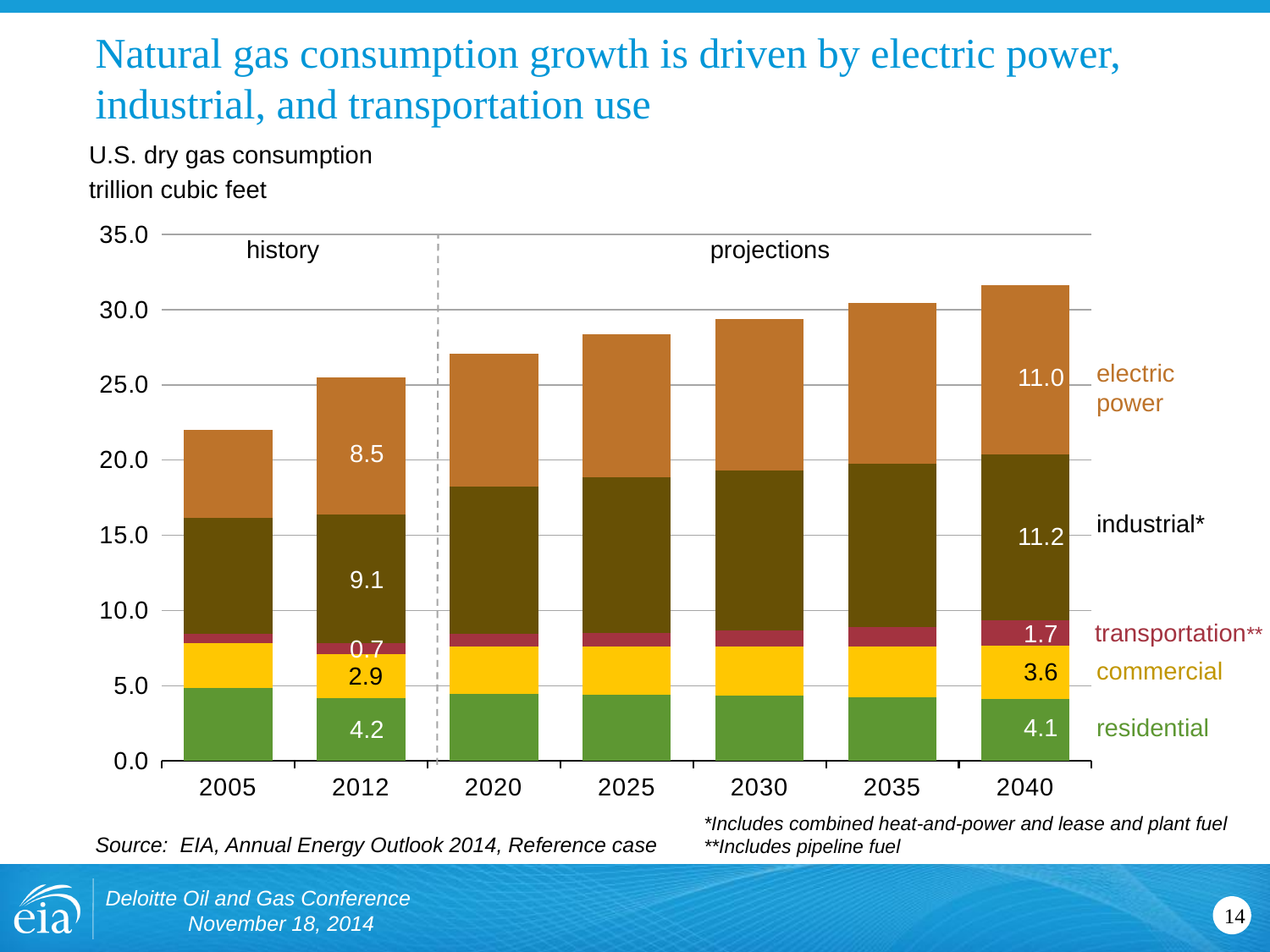
Do the total bar heights rise or fall from 2005 to 2040? Rise What kind of chart is shown on the slide? Stacked bar chart What is the total of the stacked bar for 2040? 31.6 In 2040, which sector has the smallest segment? transportation How many years are shown on the x axis? 7 What is the transportation value shown for 2040? 1.7 What is the electric power consumption value shown for 2012? 8.5 How many sectors (series) are stacked in each bar? 5 What is the total of the stacked bar for 2012? 25.5 What is the industrial consumption value shown for 2040? 11.2 Is the total value for 2005 greater or less than 20.0? greater By how much does the electric power value in 2040 exceed the electric power value in 2012? 2.5